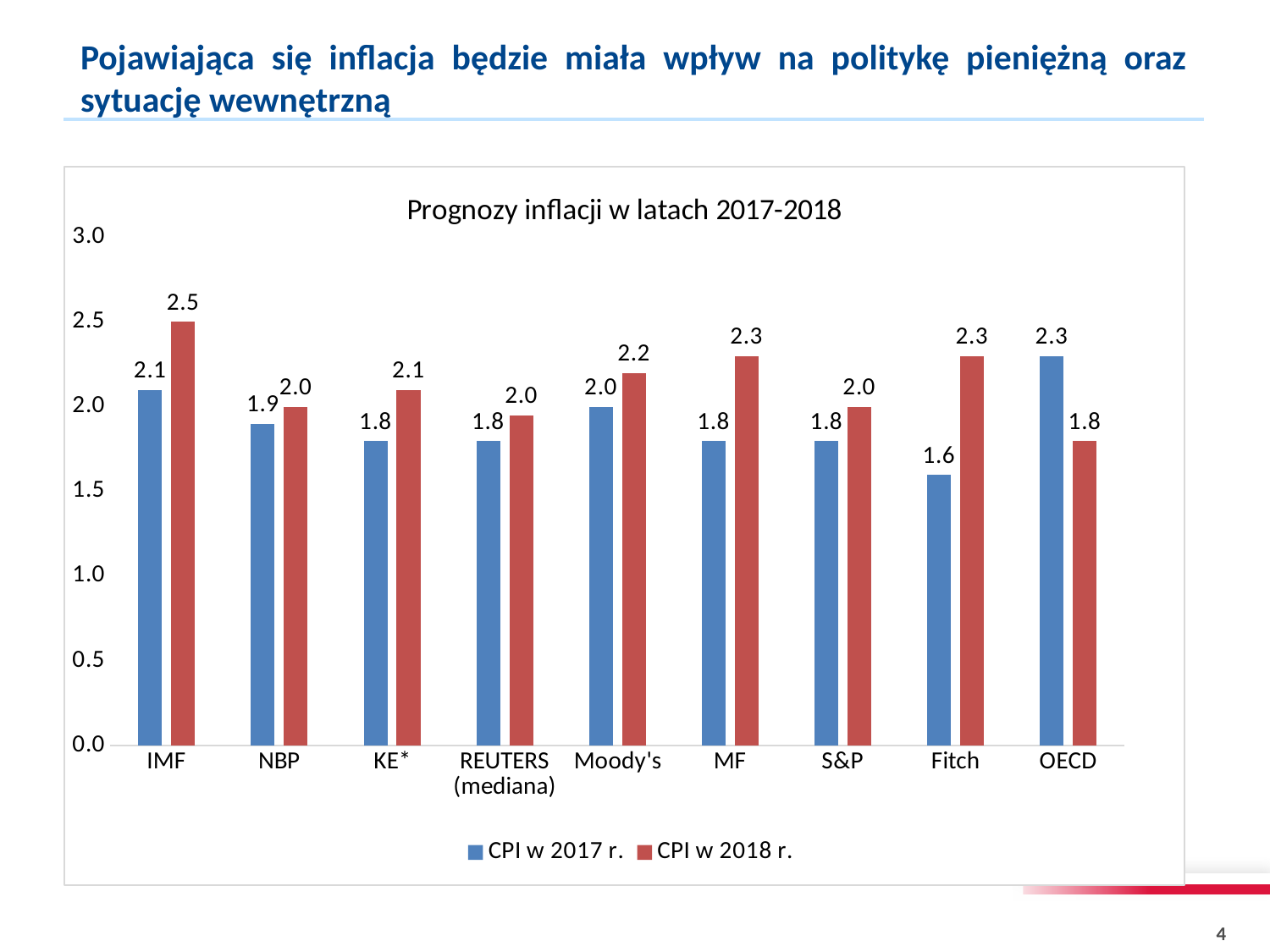
What kind of chart is shown? Bar chart What is the CPI w 2018 r. value for OECD? 1.8 What is the CPI w 2018 r. value for Fitch? 2.3 What is the title of the chart? Prognozy inflacji w latach 2017-2018 What is the CPI w 2017 r. value for IMF? 2.1 Which institution has the lowest CPI w 2018 r. forecast? OECD Which institution has the highest CPI w 2018 r. forecast? IMF What is the difference between the CPI w 2018 r. and CPI w 2017 r. values for Fitch? 0.7 How many series does the legend list? 2 Which institution has the lowest CPI w 2017 r. forecast? Fitch How many institutions are shown on the x axis? 9 Which is larger for OECD: CPI w 2017 r. or CPI w 2018 r.? CPI w 2017 r.